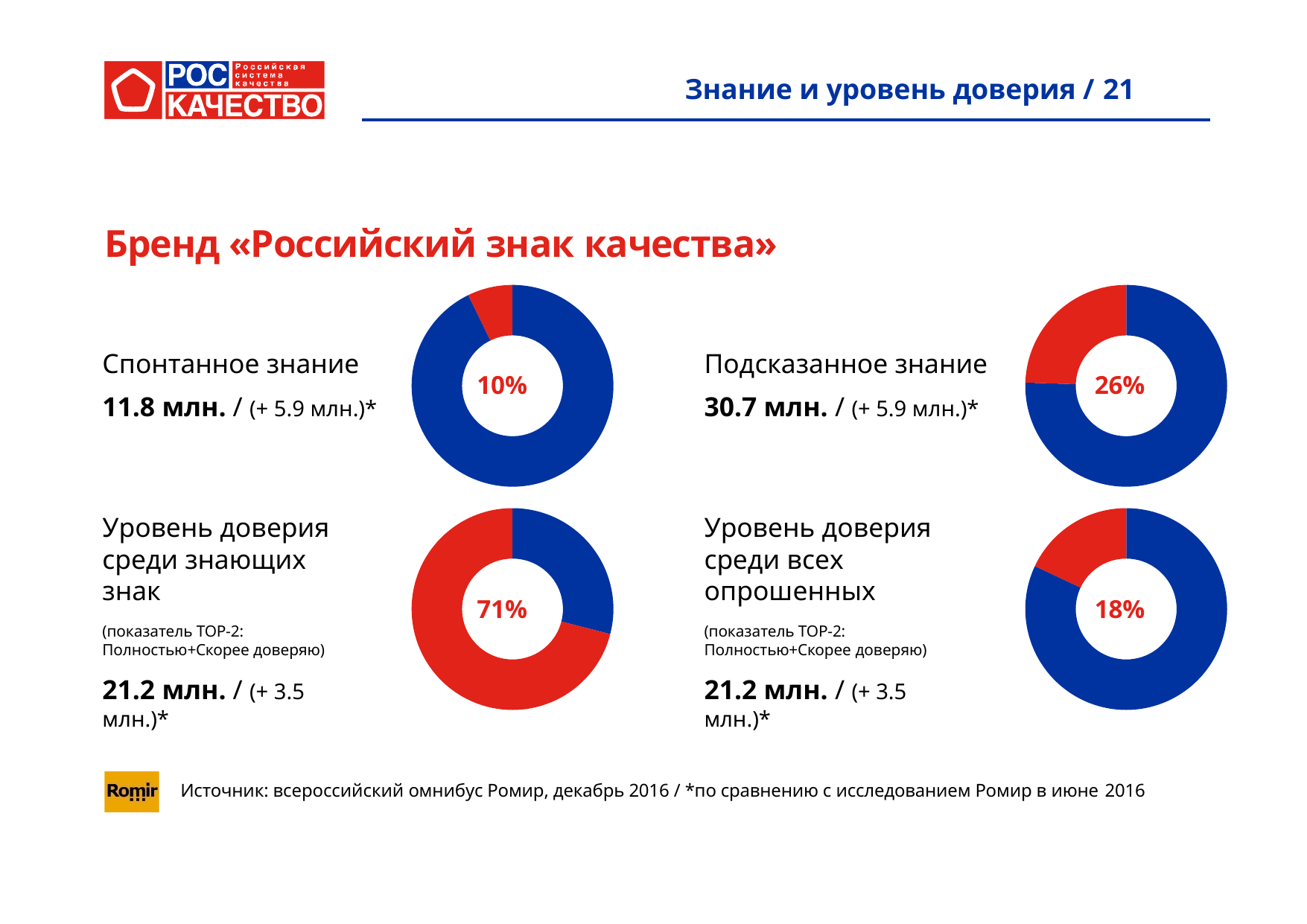
What kind of chart is used on this slide? Donut (pie) chart What percentage is shown in the 'Уровень доверия среди знающих знак' donut chart? 71% What colour is the slice representing the highlighted percentage in each donut chart? Red Which of the four donut charts shows the highest percentage? Уровень доверия среди знающих знак Which is larger: the percentage for 'Подсказанное знание' or for 'Спонтанное знание'? Подсказанное знание What percentage is shown in the centre of the 'Подсказанное знание' donut chart? 26% What percentage is shown in the 'Уровень доверия среди всех опрошенных' donut chart? 18% What is the difference in percentage points between 'Подсказанное знание' (26%) and 'Спонтанное знание' (10%)? 16 What is the difference in percentage points between the trust level among those who know the mark (71%) and among all respondents (18%)? 53 How many donut charts are on the slide? 4 What percentage is shown in the centre of the 'Спонтанное знание' donut chart? 10% Which of the four donut charts shows the lowest percentage? Спонтанное знание